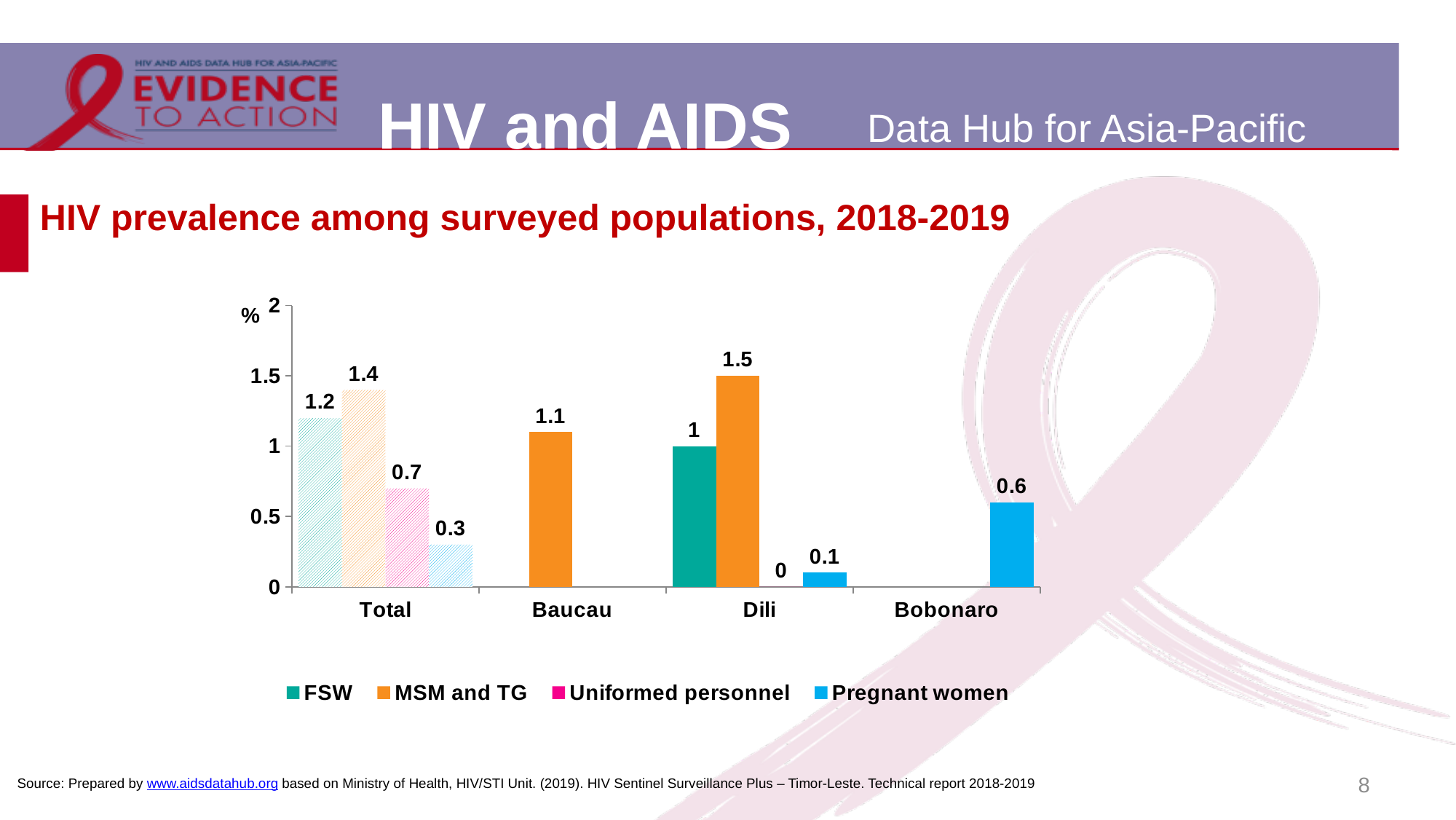
What is the HIV prevalence for Uniformed personnel in Dili? 0 Which series has the lowest value in the Total category? Pregnant women What is the HIV prevalence for MSM and TG in the Total category? 1.4 What is the HIV prevalence for FSW in Dili? 1 What is the HIV prevalence for Pregnant women in Bobonaro? 0.6 Which is larger: the FSW value in Dili or the FSW value in the Total category? FSW value in the Total category What is the title of the chart? HIV prevalence among surveyed populations, 2018-2019 How many categories are shown on the x axis? 4 How many series does the legend list? 4 What kind of chart is shown on the slide? Bar chart Which series has the highest value in the Total category? MSM and TG What is the difference between the MSM and TG value in Dili and the MSM and TG value in Baucau? 0.4